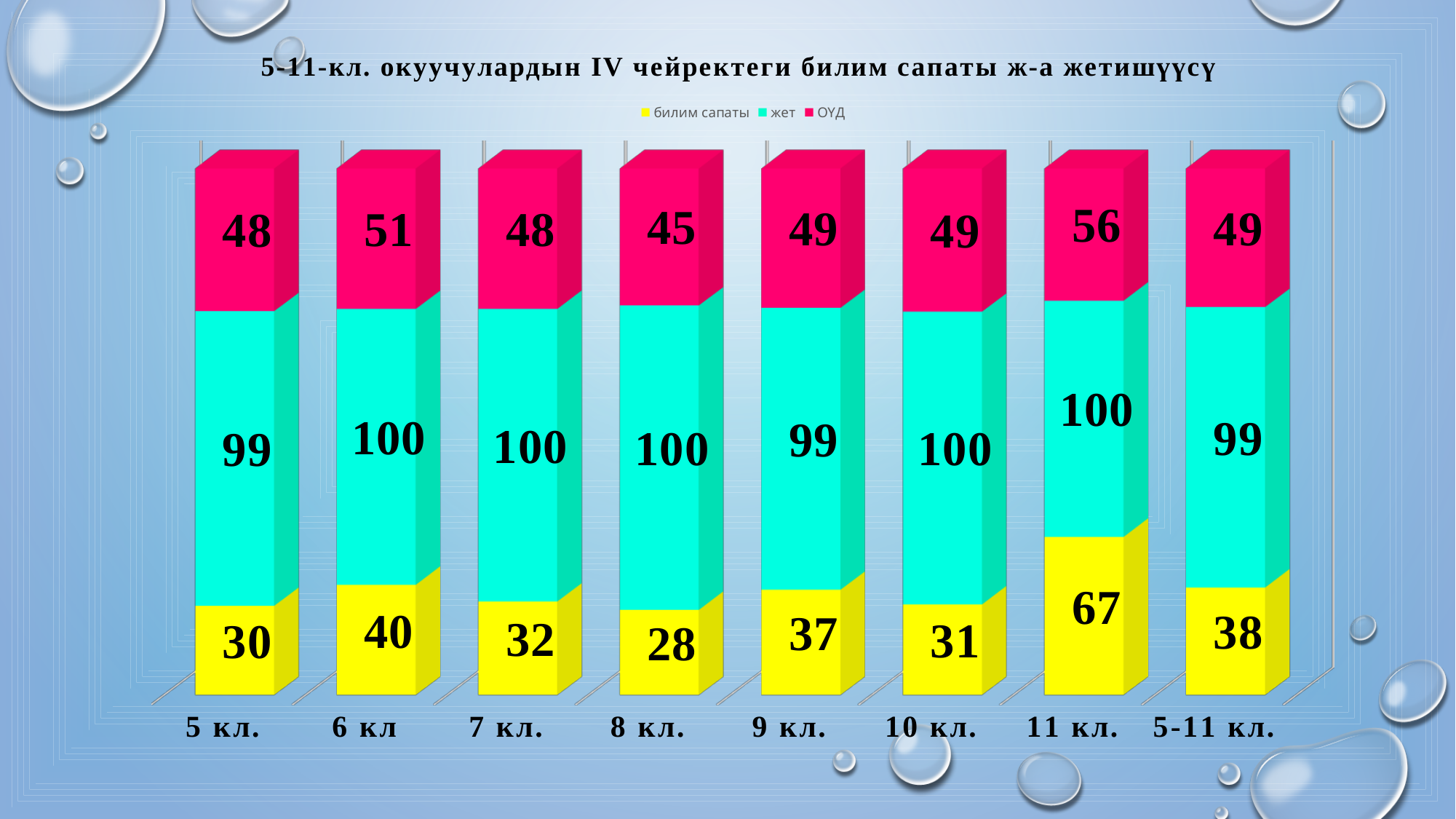
What is the value of жет for 9 кл.? 99 How many categories are shown on the x axis? 8 What is the value of билим сапаты for 11 кл.? 67 Which is larger, the ОҮД value for 11 кл. or for 6 кл? 11 кл. What kind of chart is shown on the slide? Stacked bar chart Which category has the highest билим сапаты value? 11 кл. What is the value of билим сапаты for 5-11 кл.? 38 Which category has the lowest ОҮД value? 8 кл. What is the difference between the билим сапаты values for 11 кл. and 5 кл.? 37 Which category has the lowest билим сапаты value? 8 кл. What is the value of ОҮД for 6 кл? 51 How many series does the legend list? 3